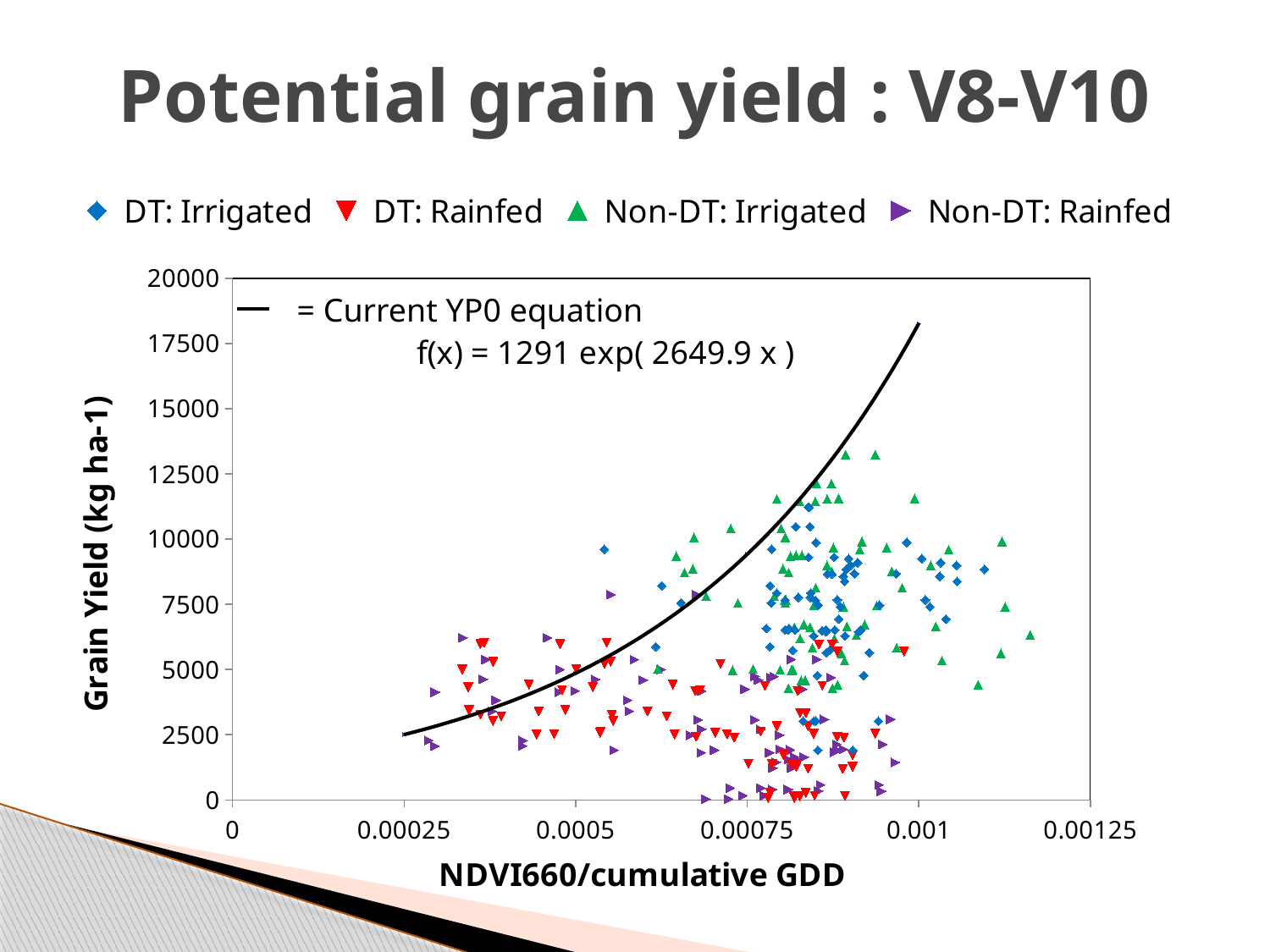
Is the lowest grain yield in the DT: Rainfed series greater or less than 2500? less How many data series does the legend list? 4 What equation is printed for the Current YP0 curve? f(x) = 1291 exp( 2649.9 x ) Does the fitted 'Current YP0 equation' curve rise or fall as NDVI660/cumulative GDD increases? rises Which series reaches a higher maximum grain yield, DT: Rainfed or Non-DT: Irrigated? Non-DT: Irrigated Is the highest grain yield reached by the Non-DT: Irrigated series greater or less than 10000? greater What is the title of the y axis? Grain Yield (kg ha-1) What kind of chart is shown on the slide? scatter chart Is the highest grain yield reached by the DT: Irrigated series greater or less than 12500? less Which series reaches the highest grain yield on the chart? Non-DT: Irrigated